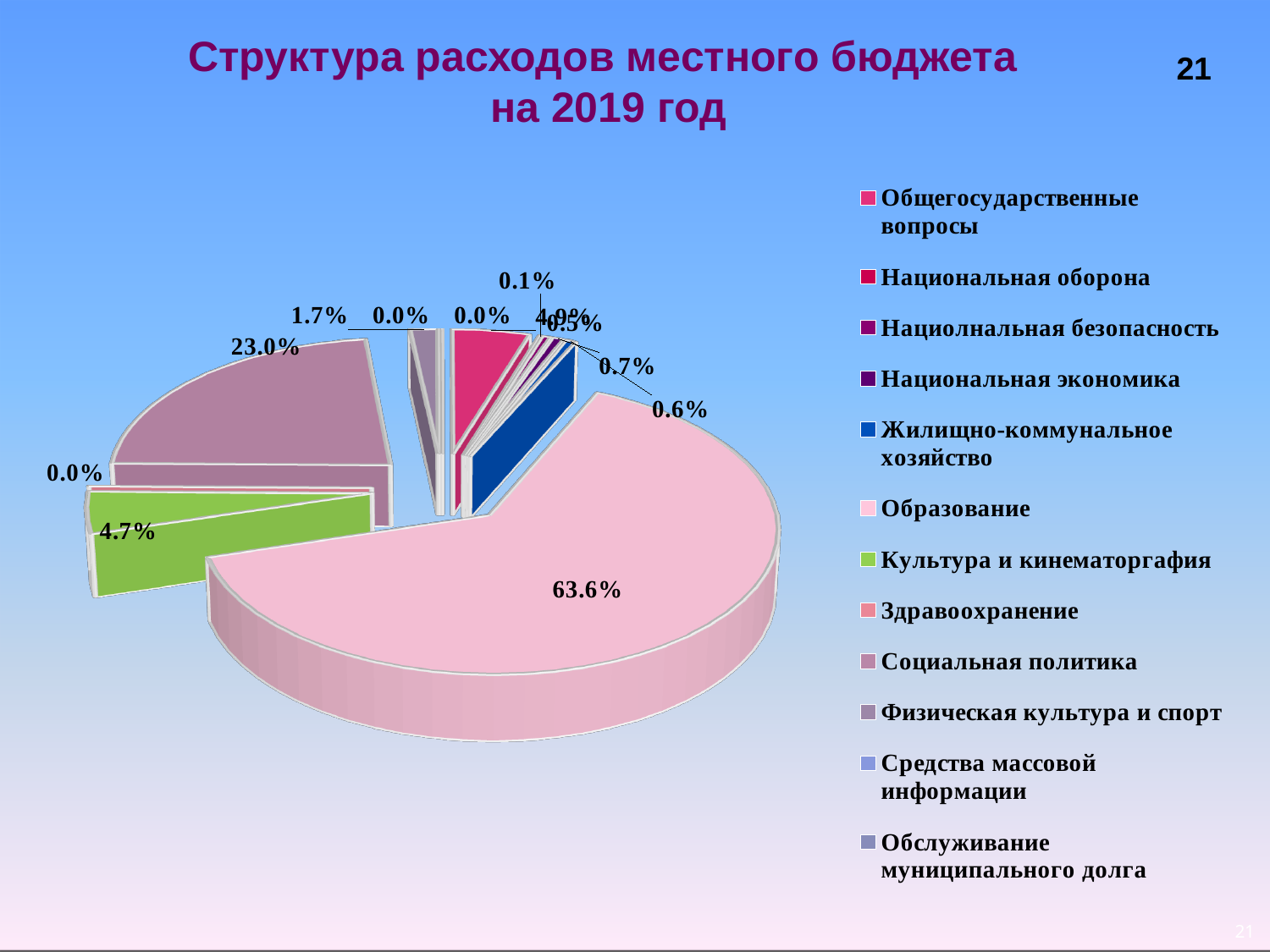
Which is larger, the slice for Социальная политика or the slice for Культура и кинематоргафия? Социальная политика Which legend entry is shown in green? Культура и кинематоргафия What share of the pie does Социальная политика have? 23.0% What is the difference in percentage points between the Социальная политика slice and the Культура и кинематоргафия slice? 18.3 What share of the pie does Образование have? 63.6% What kind of chart is shown on the slide? pie chart Which is larger, the slice for Образование or the slice for Социальная политика? Образование What is the difference in percentage points between the Образование slice and the Социальная политика slice? 40.6 Which category has the largest slice of the pie? Образование How many categories does the legend list? 12 What is the title of the chart? Структура расходов местного бюджета на 2019 год What share of the pie does Культура и кинематоргафия have? 4.7%